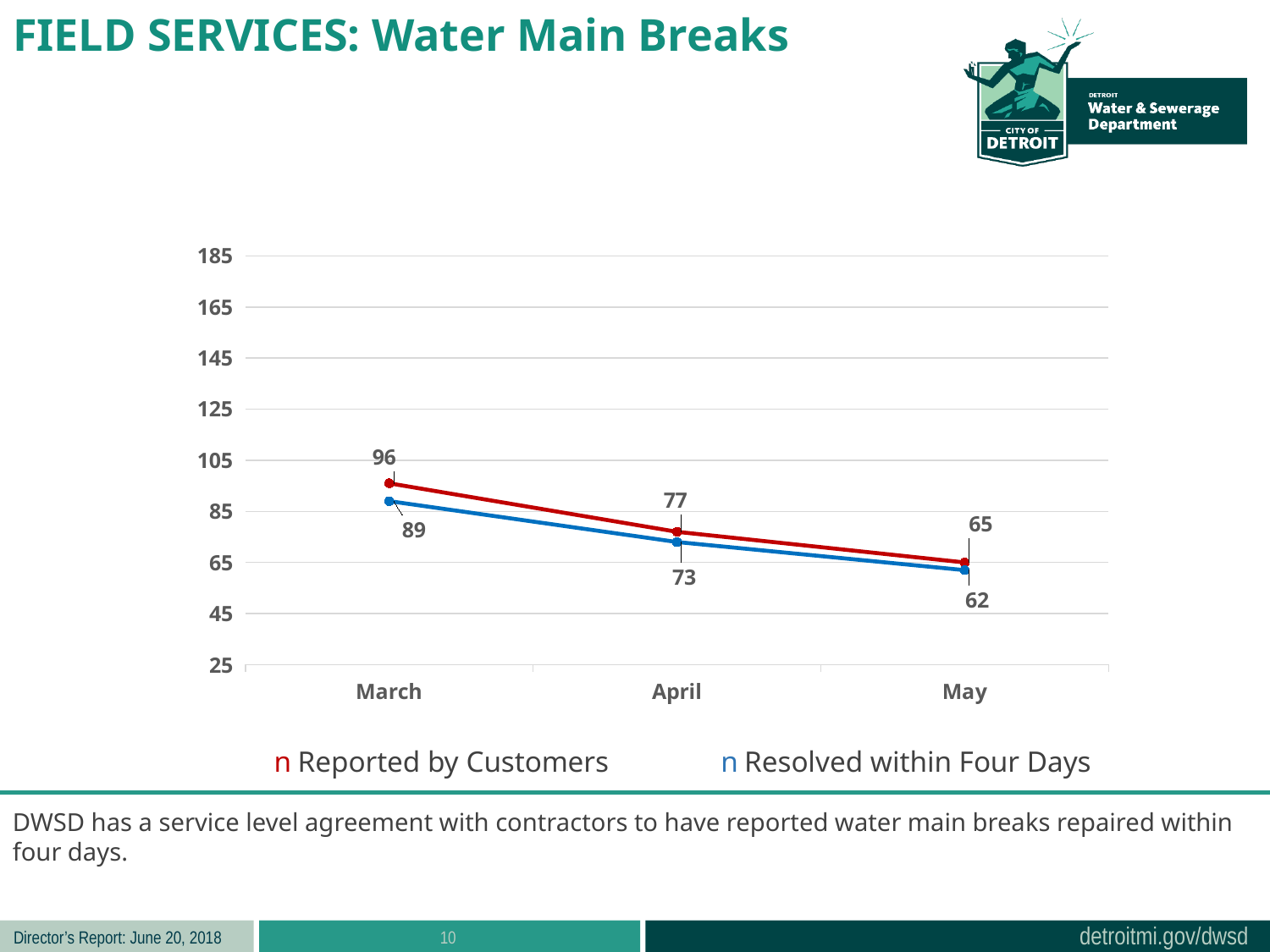
How many series does the legend list? 2 What kind of chart is shown on the slide? Line chart Which is larger in April: breaks reported by customers or breaks resolved within four days? Reported by Customers How many months are shown on the x axis? 3 How many water main breaks were resolved within four days in April? 73 Do the values for breaks reported by customers rise or fall from March to May? Fall How many water main breaks were reported by customers in May? 65 In which month was the number of breaks reported by customers highest? March What is the difference between breaks reported by customers and breaks resolved within four days in March? 7 What is the difference between breaks reported by customers in March and in May? 31 In which month was the number of breaks resolved within four days lowest? May How many water main breaks were reported by customers in March? 96